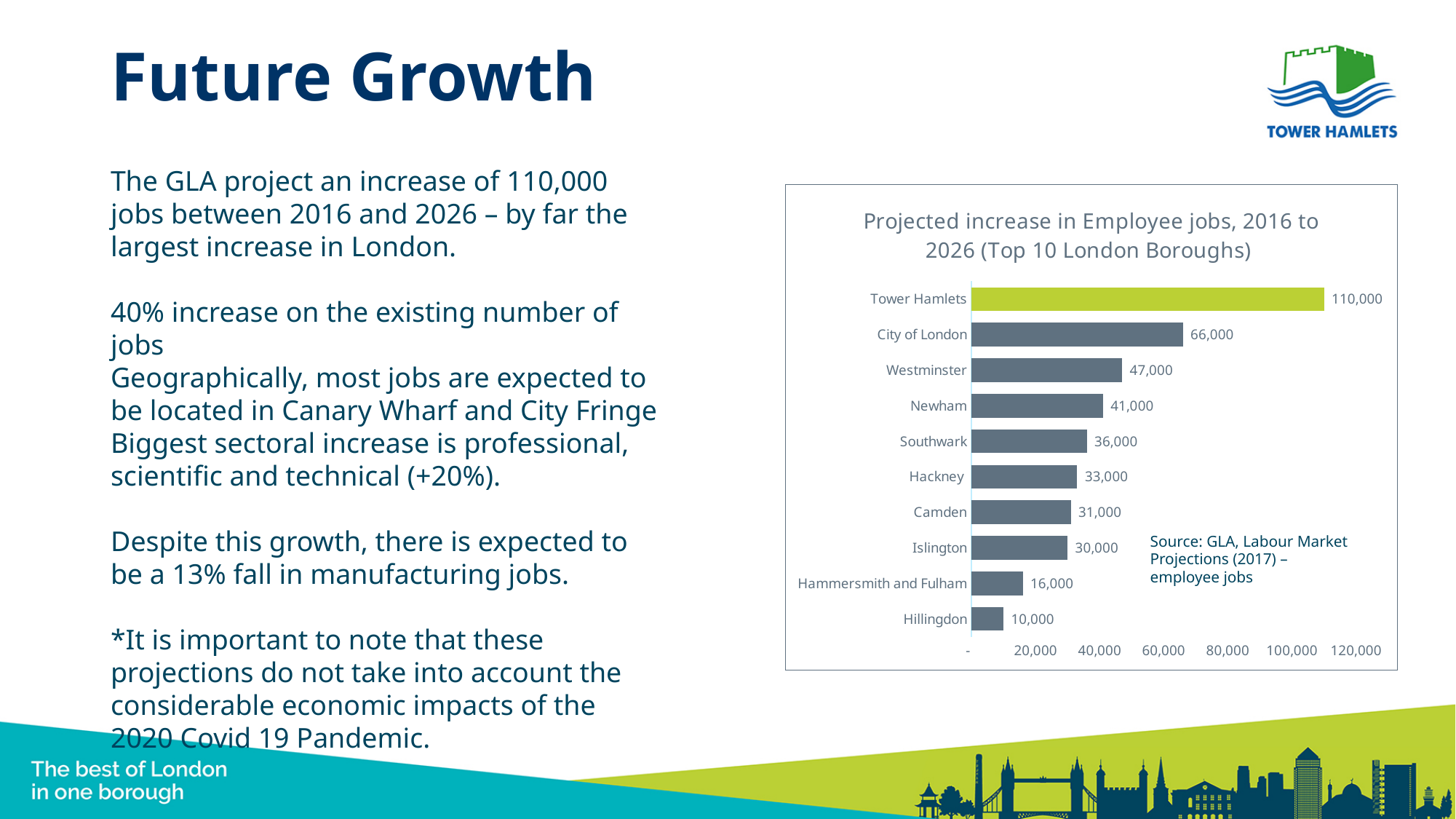
Is the projected increase for City of London greater or less than 60,000? greater What is the projected increase in employee jobs for Hammersmith and Fulham? 16,000 What is the projected increase in employee jobs for Tower Hamlets? 110,000 What is the projected increase in employee jobs for Southwark? 36,000 What kind of chart is shown on the slide? Bar chart How many boroughs are shown in the chart? 10 What is the difference between the projected increase for Westminster and Newham? 6,000 Which has a larger projected increase in employee jobs, Hackney or Camden? Hackney Which borough has the lowest projected increase in employee jobs? Hillingdon What is the title of the chart? Projected increase in Employee jobs, 2016 to 2026 (Top 10 London Boroughs) Which borough has the highest projected increase in employee jobs? Tower Hamlets What is the difference between the projected increase for Tower Hamlets and City of London? 44,000